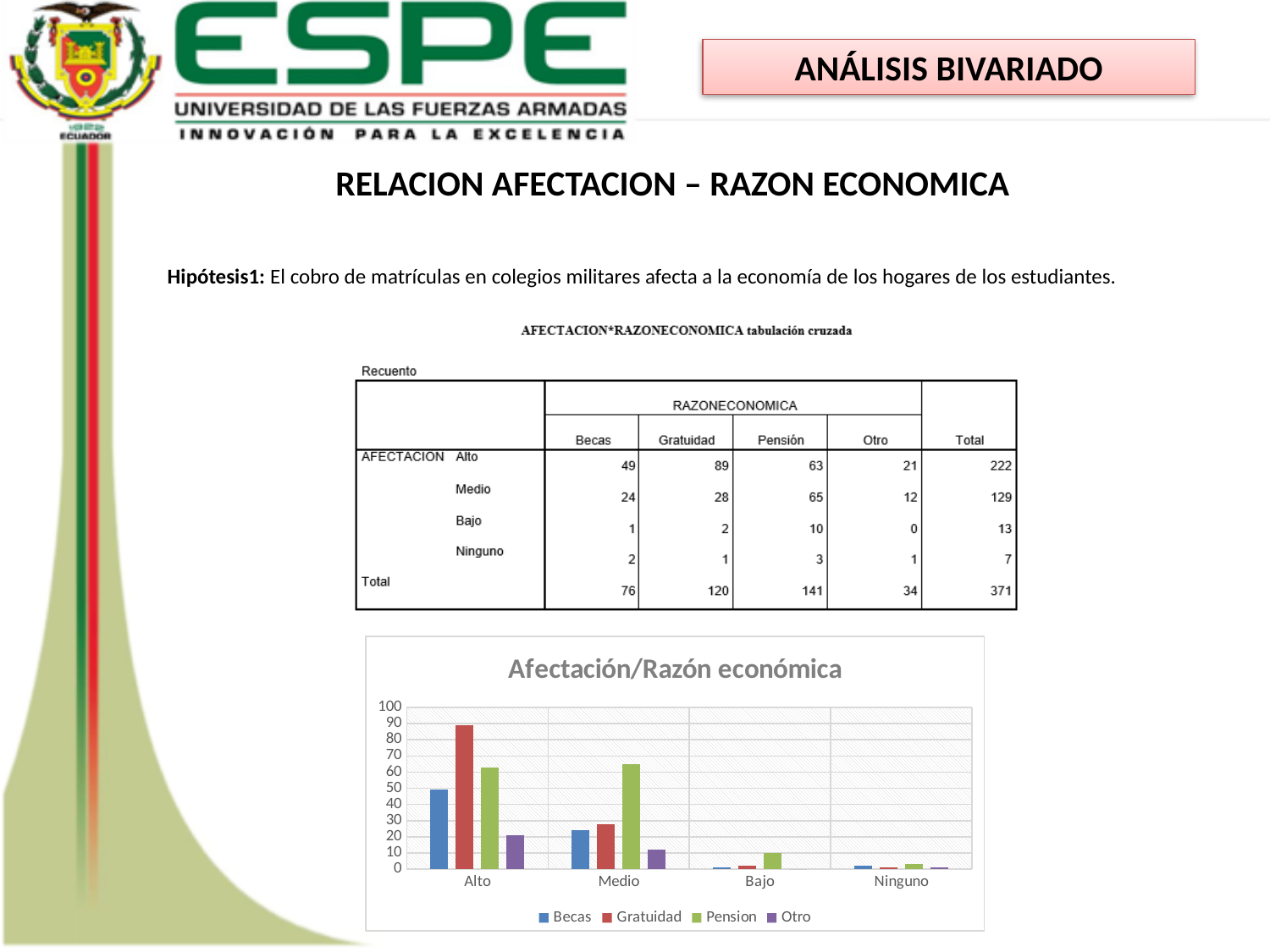
In the 'Afectación/Razón económica' chart, is the Gratuidad value for Alto greater or less than 80? greater How many series does the legend of the 'Afectación/Razón económica' chart list? 4 What kind of chart is shown under the title 'Afectación/Razón económica'? bar chart In the 'Afectación/Razón económica' chart, which is larger: the Becas bar for Alto or the Becas bar for Medio? Alto In the 'Afectación/Razón económica' chart, do the Gratuidad bars rise or fall from Alto to Ninguno? fall In the 'Afectación/Razón económica' chart, is the Becas value for Alto greater or less than 40? greater In the 'Afectación/Razón económica' chart, is the Otro value for Medio greater or less than 20? less According to the cross-tabulation table on the slide, what is the overall Total count? 371 According to the cross-tabulation table on the slide, what is the count for AFECTACION Alto and Pensión? 63 How many categories are shown on the x axis of the 'Afectación/Razón económica' chart? 4 In the 'Afectación/Razón económica' chart, which series has the tallest bar for Medio? Pension In the 'Afectación/Razón económica' chart, which series has the tallest bar for Alto? Gratuidad